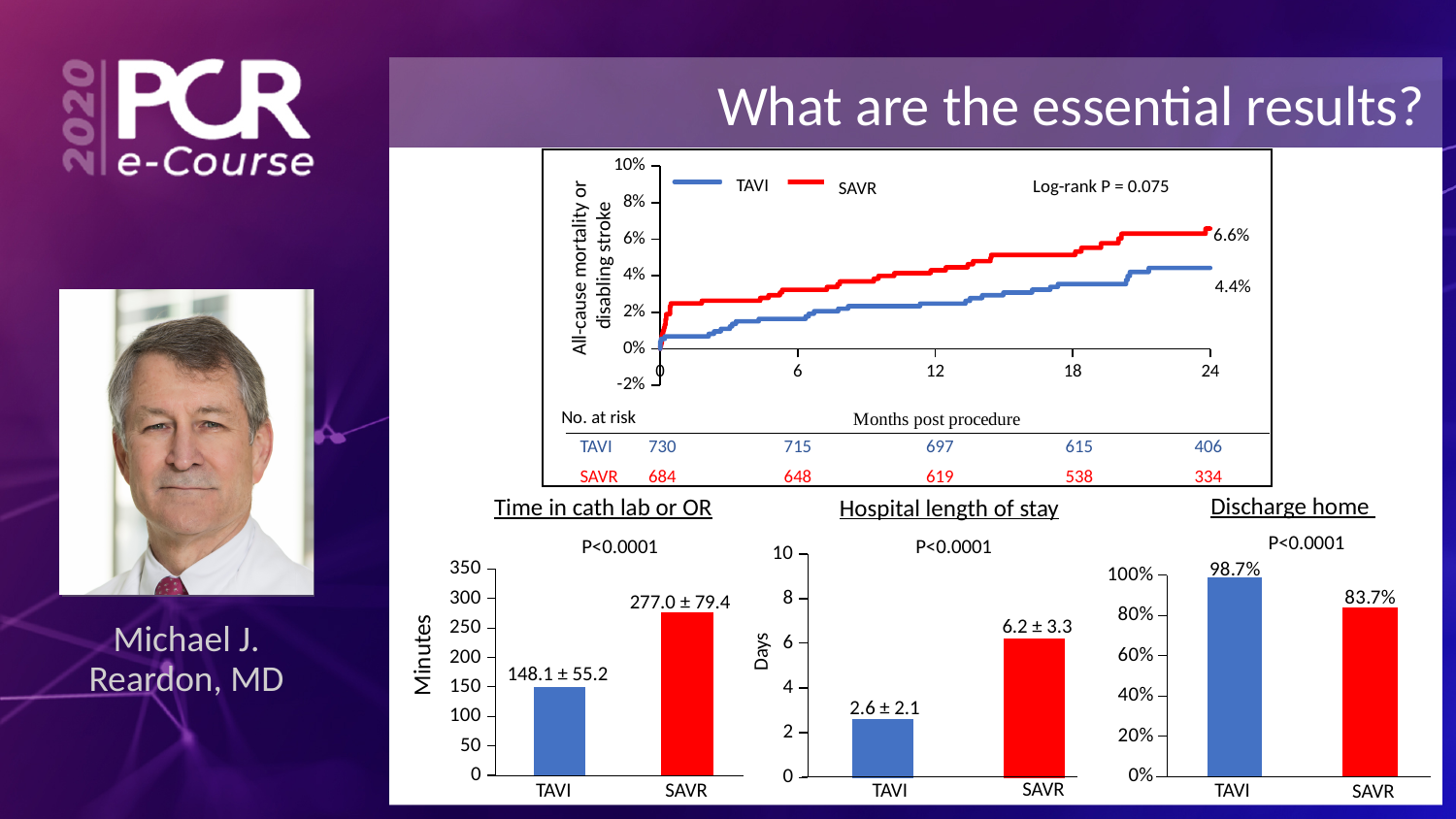
In the top chart of all-cause mortality or disabling stroke, how many series does the legend list? 2 In the 'Time in cath lab or OR' chart, which group has the higher value, TAVI or SAVR? SAVR In the 'Discharge home' chart, what is the difference between the TAVI and SAVR values? 15.0% In the 'Discharge home' chart, what is the value for TAVI? 98.7% In the 'Discharge home' chart, what is the value for SAVR? 83.7% In the top chart of all-cause mortality or disabling stroke, what is the value shown for SAVR at 24 months? 6.6% In the 'Time in cath lab or OR' chart, is the value for SAVR greater or less than 250? greater In the 'Discharge home' chart, which group has the lowest value? SAVR In the 'Hospital length of stay' chart, what is the value labelled for TAVI? 2.6 ± 2.1 What kind of chart is the 'Hospital length of stay' chart? bar chart In the 'Hospital length of stay' chart, is the value for TAVI greater or less than 4? less In the 'Time in cath lab or OR' chart, what is the value labelled for SAVR? 277.0 ± 79.4